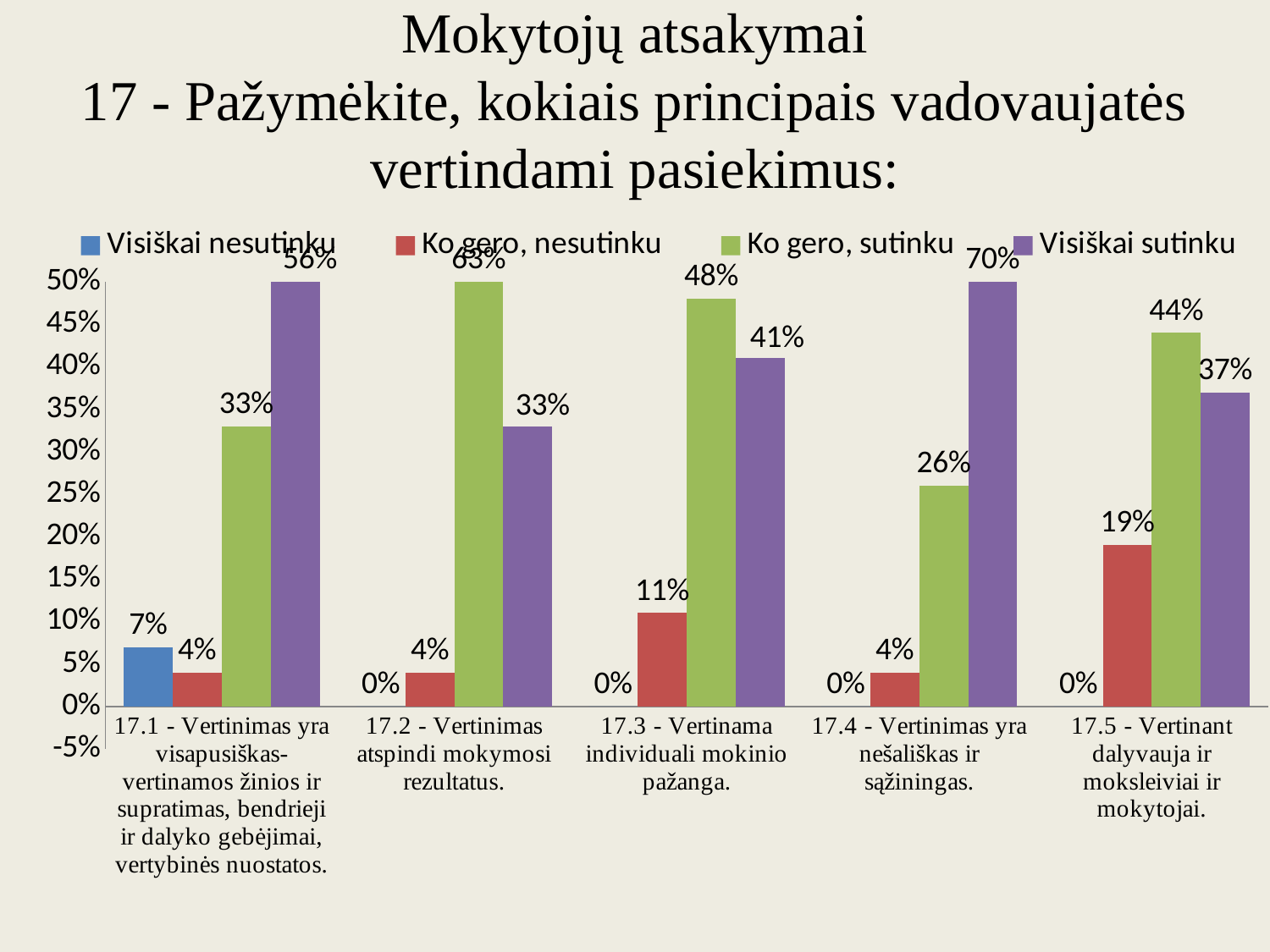
Which series is shown in green in the legend? Ko gero, sutinku Which category has the lowest "Ko gero, sutinku" value? 17.4 - Vertinimas yra nešališkas ir sąžiningas. What is the value of "Ko gero, sutinku" for category 17.2 - Vertinimas atspindi mokymosi rezultatus? 63% What is the value of "Ko gero, nesutinku" for category 17.5 - Vertinant dalyvauja ir moksleiviai ir mokytojai? 19% What is the value of "Visiškai sutinku" for category 17.4 - Vertinimas yra nešališkas ir sąžiningas? 70% What is the difference between the "Visiškai sutinku" and "Ko gero, sutinku" values for category 17.1? 23% How many series does the legend list? 4 What is the value of "Visiškai nesutinku" for category 17.1? 7% What kind of chart is shown on the slide? bar chart For category 17.3 - Vertinama individuali mokinio pažanga, which is larger: "Ko gero, sutinku" or "Visiškai sutinku"? Ko gero, sutinku Which category has the highest "Visiškai sutinku" value? 17.4 - Vertinimas yra nešališkas ir sąžiningas. How many categories (questions 17.1 to 17.5) are shown on the x axis? 5